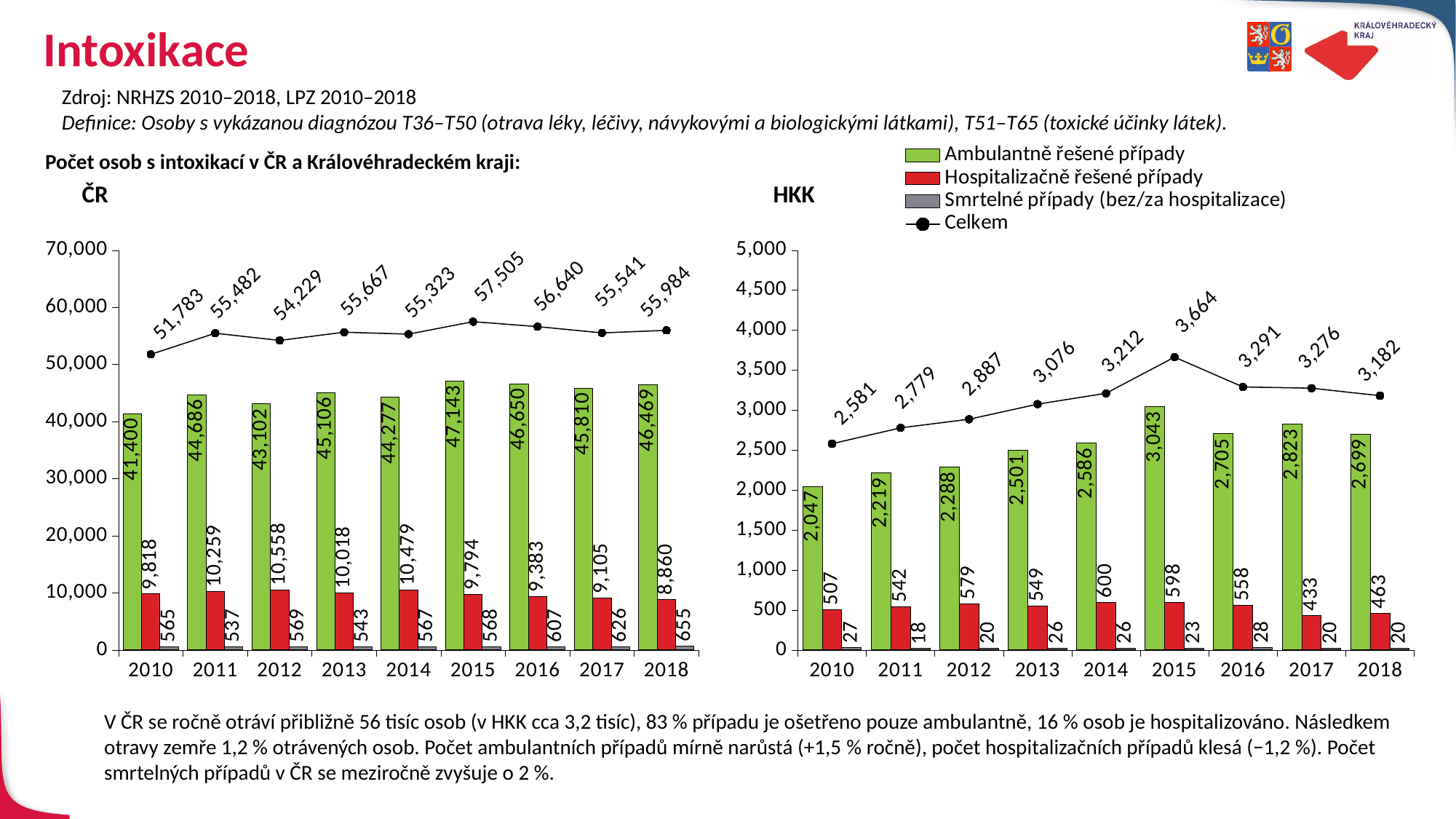
What kind of chart is the ČR chart? Combined bar and line chart In the ČR chart, what is the value of Ambulantně řešené případy in 2015? 47,143 In the HKK chart, which year has the larger Ambulantně řešené případy value, 2017 or 2018? 2017 What colour are the bars for Hospitalizačně řešené případy? Red In the ČR chart, what is the difference between the Celkem value in 2018 and in 2010? 4,201 In the HKK chart, in which year is the Smrtelné případy value lowest? 2011 In the HKK chart, what is the value of Hospitalizačně řešené případy in 2014? 600 In the HKK chart, how many years are shown on the x axis? 9 In the ČR chart, what is the value of Smrtelné případy in 2018? 655 In the HKK chart, does the Celkem line rise or fall from 2010 to 2015? Rise In the ČR chart, in which year is the Celkem value highest? 2015 How many series does the legend list? 4